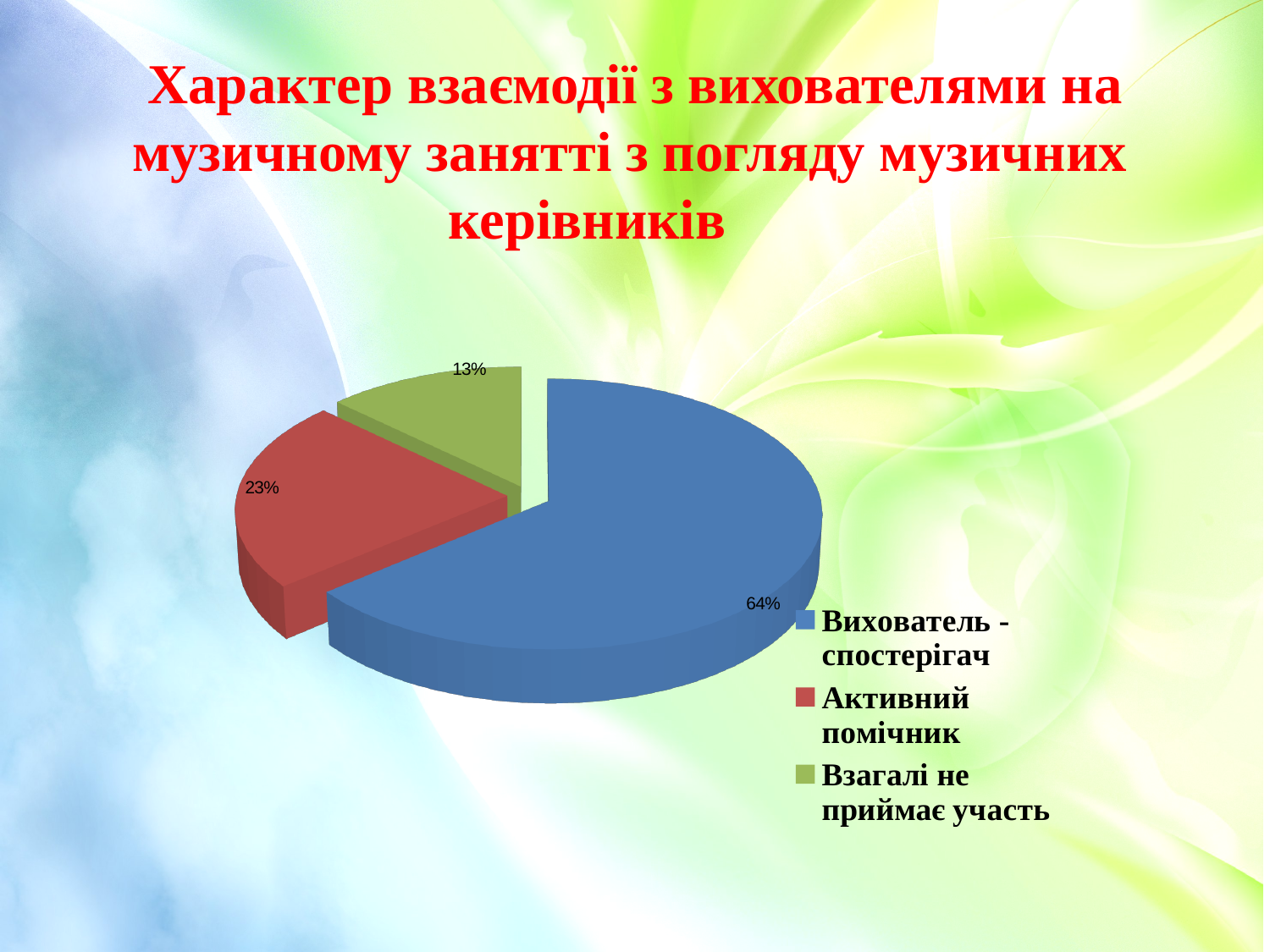
What kind of chart is shown on the slide? pie chart What colour is the slice for "Вихователь - спостерігач"? blue Which category has the smallest slice of the pie? Взагалі не приймає участь What is the difference in percentage points between "Вихователь - спостерігач" and "Активний помічник"? 41 Which category has the largest slice of the pie? Вихователь - спостерігач What share of the pie does "Активний помічник" take? 23% What share of the pie does "Вихователь - спостерігач" take? 64% What share of the pie does "Взагалі не приймає участь" take? 13% Which is larger, the slice for "Активний помічник" or the slice for "Взагалі не приймає участь"? Активний помічник How many entries does the legend list? 3 What is the difference in percentage points between "Активний помічник" and "Взагалі не приймає участь"? 10 How many slices does the pie chart have? 3